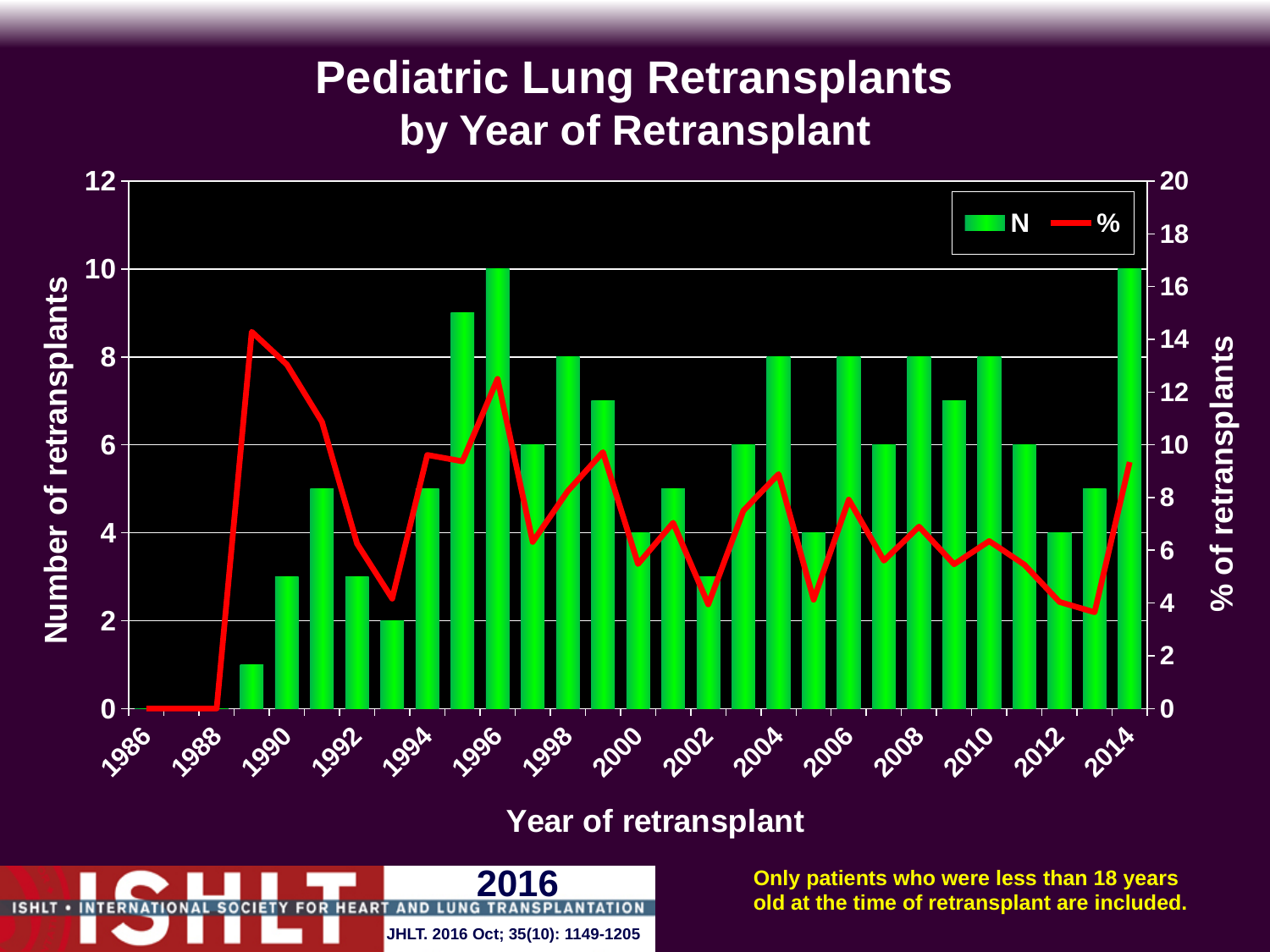
What is the highest number of retransplants (N) reached in any year? 10 What is the number of retransplants (N) in 1998? 8 Do the bars rise or fall from 2010 to 2012? fall What is the number of retransplants (N) in 2012? 4 Is the % of retransplants in 1989 greater or less than 12? greater What is the title of the right-hand vertical axis? % of retransplants Which year has more retransplants, 1998 or 2000? 1998 How many series does the legend list? 2 Is the number of retransplants in 1995 greater or less than 8? greater What is the number of retransplants (N) in 1993? 2 What is the difference in number of retransplants between 2010 and 2012? 4 What is the number of retransplants (N) in 1996? 10